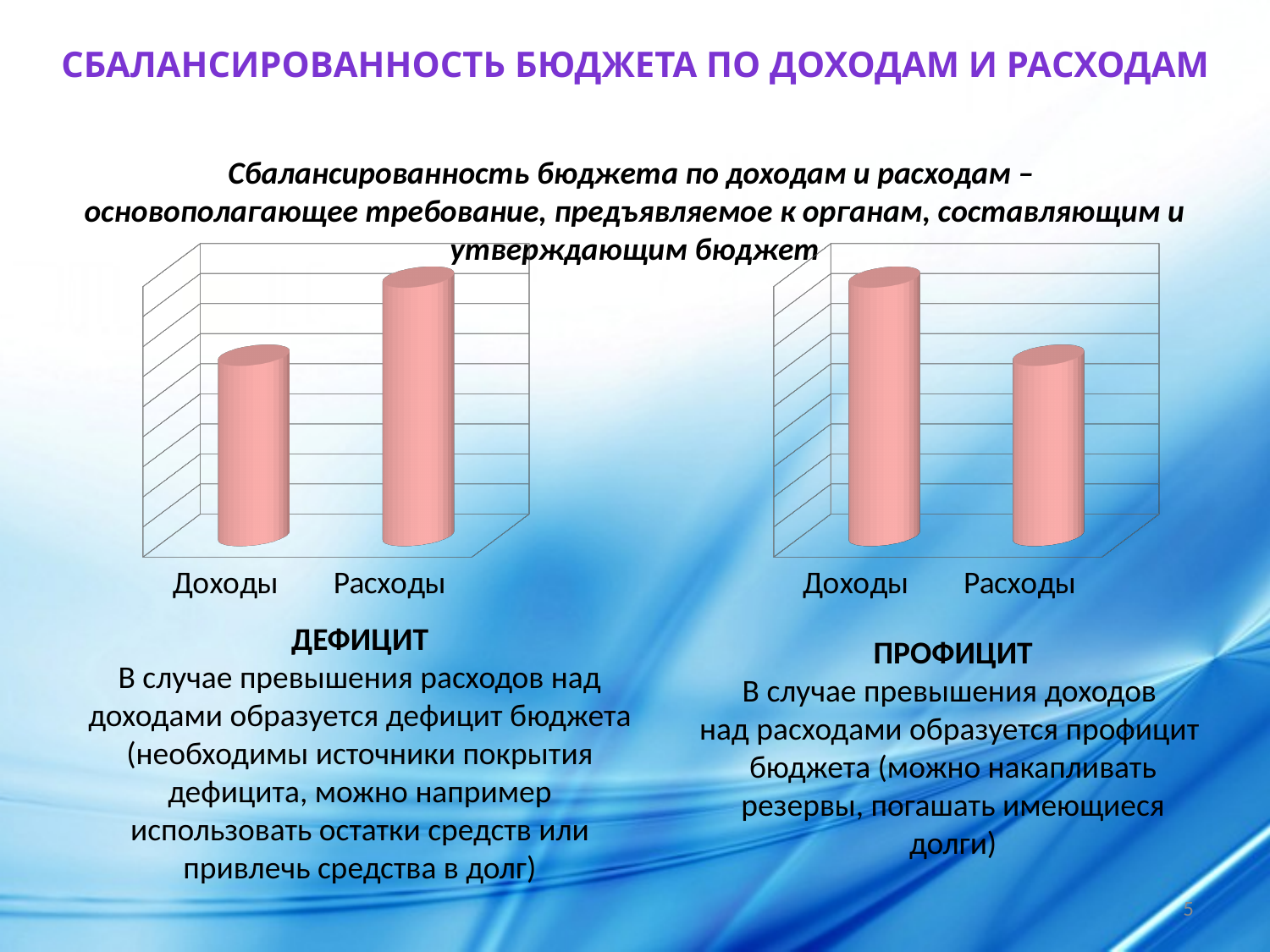
In the right chart, which is larger: Доходы or Расходы? Доходы In the right chart, which category has the highest bar? Доходы What kind of chart is the left chart on the slide? bar chart How many categories does the left chart show? 2 In the left chart, which is larger: Доходы or Расходы? Расходы What kind of chart is the right chart on the slide? bar chart In the left chart, which category has the highest bar? Расходы What colour are the bars in both charts? pink How many categories does the right chart show? 2 In the right chart, do the bars rise or fall from Доходы to Расходы? fall In the left chart, which category has the lowest bar? Доходы In the right chart, which category has the lowest bar? Расходы